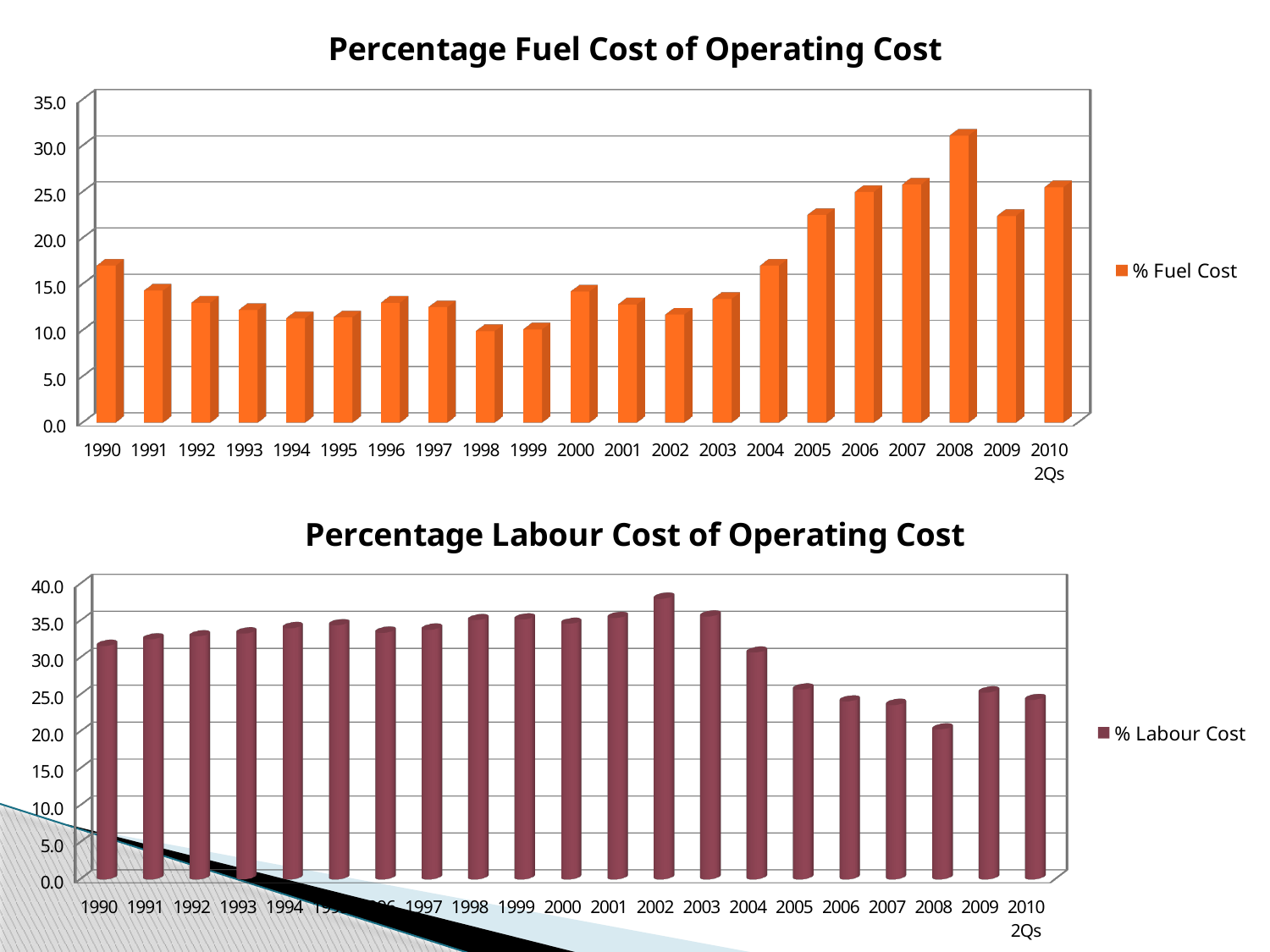
In the 'Percentage Fuel Cost of Operating Cost' chart, is the value for 1994 greater or less than 15.0? less In the 'Percentage Labour Cost of Operating Cost' chart, which year has the highest value? 2002 In the 'Percentage Labour Cost of Operating Cost' chart, is the value for 2008 greater or less than 25.0? less In the 'Percentage Labour Cost of Operating Cost' chart, do the values rise or fall from 2002 to 2008? fall What kind of chart is the 'Percentage Fuel Cost of Operating Cost' chart? bar chart In the 'Percentage Fuel Cost of Operating Cost' chart, which year has the highest value? 2008 In the 'Percentage Fuel Cost of Operating Cost' chart, do the values rise or fall from 2004 to 2008? rise In the 'Percentage Fuel Cost of Operating Cost' chart, is the value for 2005 greater or less than 20.0? greater How many series does the legend of the 'Percentage Labour Cost of Operating Cost' chart list? 1 In the 'Percentage Labour Cost of Operating Cost' chart, which year has the lowest value? 2008 How many years (categories) are shown on the x axis of the 'Percentage Fuel Cost of Operating Cost' chart? 21